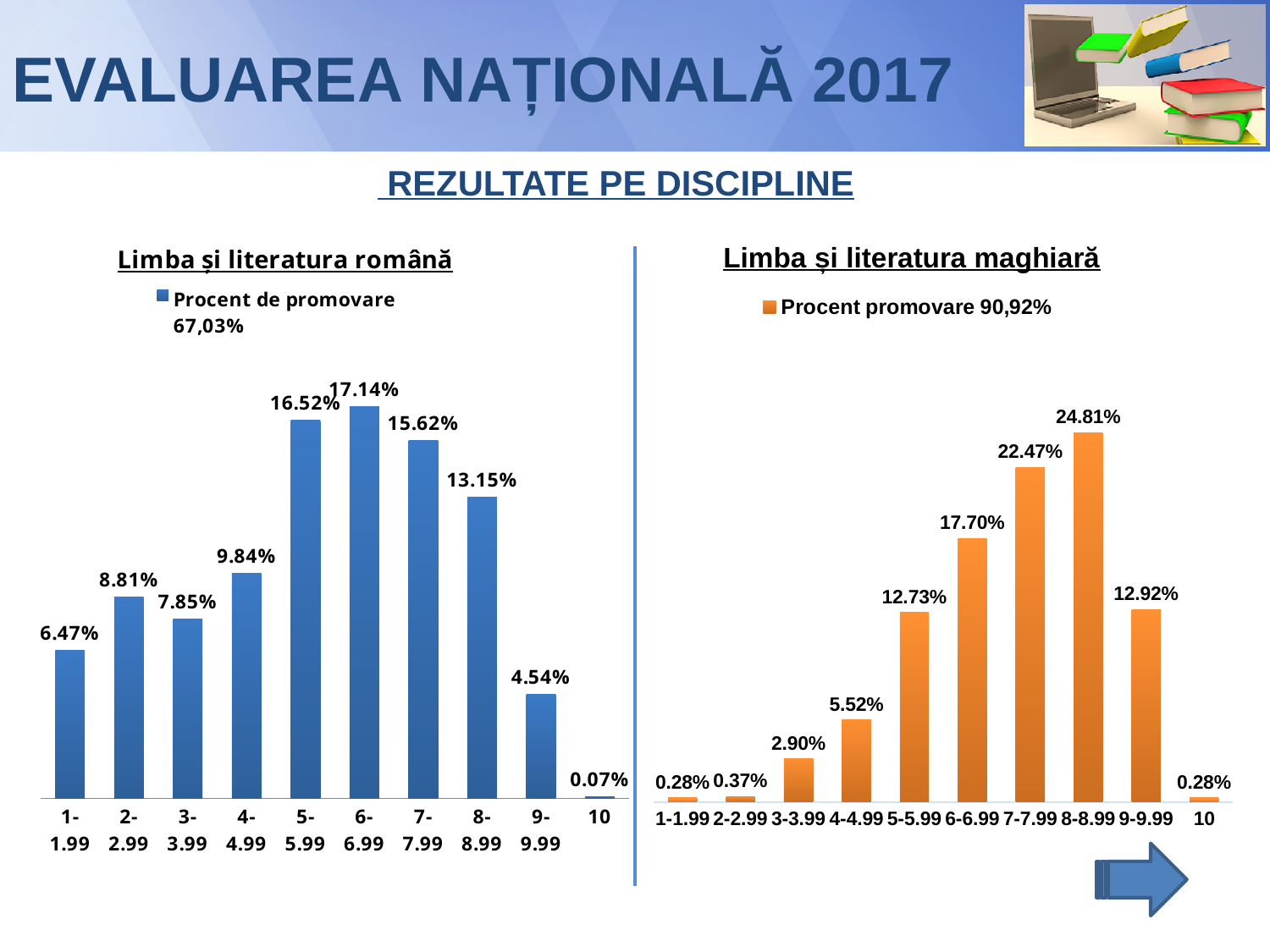
In the 'Limba și literatura română' chart, which category has the lowest value? 10 In the 'Limba și literatura română' chart, what is the value for the 6-6.99 category? 17.14% In the 'Limba și literatura maghiară' chart, do the values rise or fall from 1-1.99 to 8-8.99? Rise How many categories are shown on the x axis of the 'Limba și literatura română' chart? 10 How many series does the legend of the 'Limba și literatura română' chart list? 1 In the 'Limba și literatura română' chart, what is the difference between the values for 5-5.99 and 9-9.99? 11.98% In the 'Limba și literatura maghiară' chart, which is larger: the value for 5-5.99 or the value for 9-9.99? 9-9.99 In the 'Limba și literatura maghiară' chart, what is the value for the 10 category? 0.28% In the 'Limba și literatura maghiară' chart, which category has the highest value? 8-8.99 What is the legend entry of the 'Limba și literatura maghiară' chart? Procent promovare 90,92% What type of chart is the 'Limba și literatura maghiară' chart? Bar chart In the 'Limba și literatura maghiară' chart, what is the value for the 7-7.99 category? 22.47%